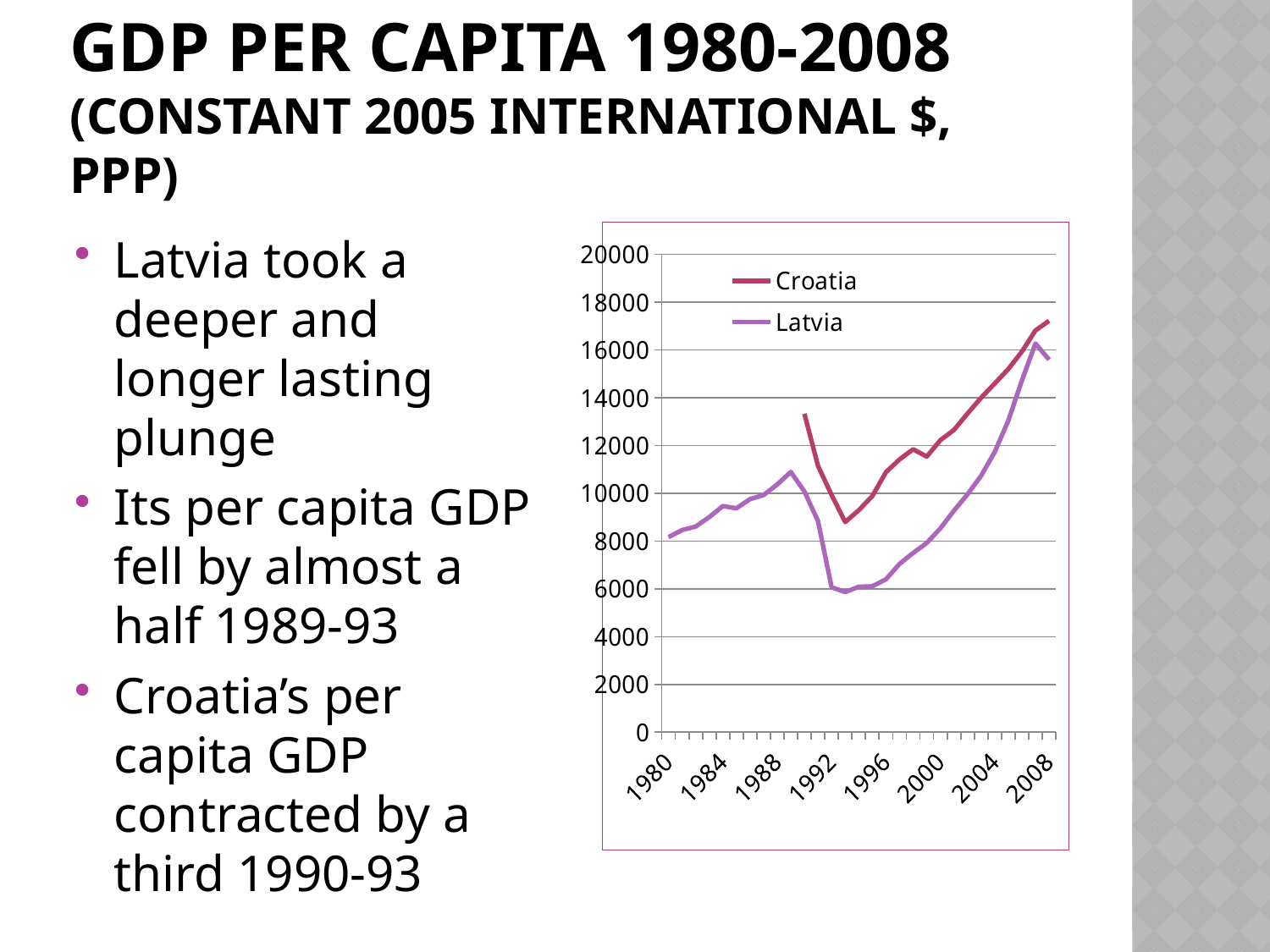
Which series is drawn in purple in the chart? Latvia Is the value for Latvia in 1993 greater or less than 8000? less How many year labels are shown on the x axis of the chart? 8 Is the value for Latvia in 1980 greater or less than 6000? greater Is the value for Croatia in 1990 greater or less than 12000? greater Does the Croatia line rise or fall between 1990 and 1993? Fall Which two countries are plotted in the chart? Croatia and Latvia In 2000, which country has the higher GDP per capita, Croatia or Latvia? Croatia Does the Latvia line rise or fall between 1980 and 1989? Rise How many series does the chart's legend list? 2 What kind of chart is shown on the slide? Line chart